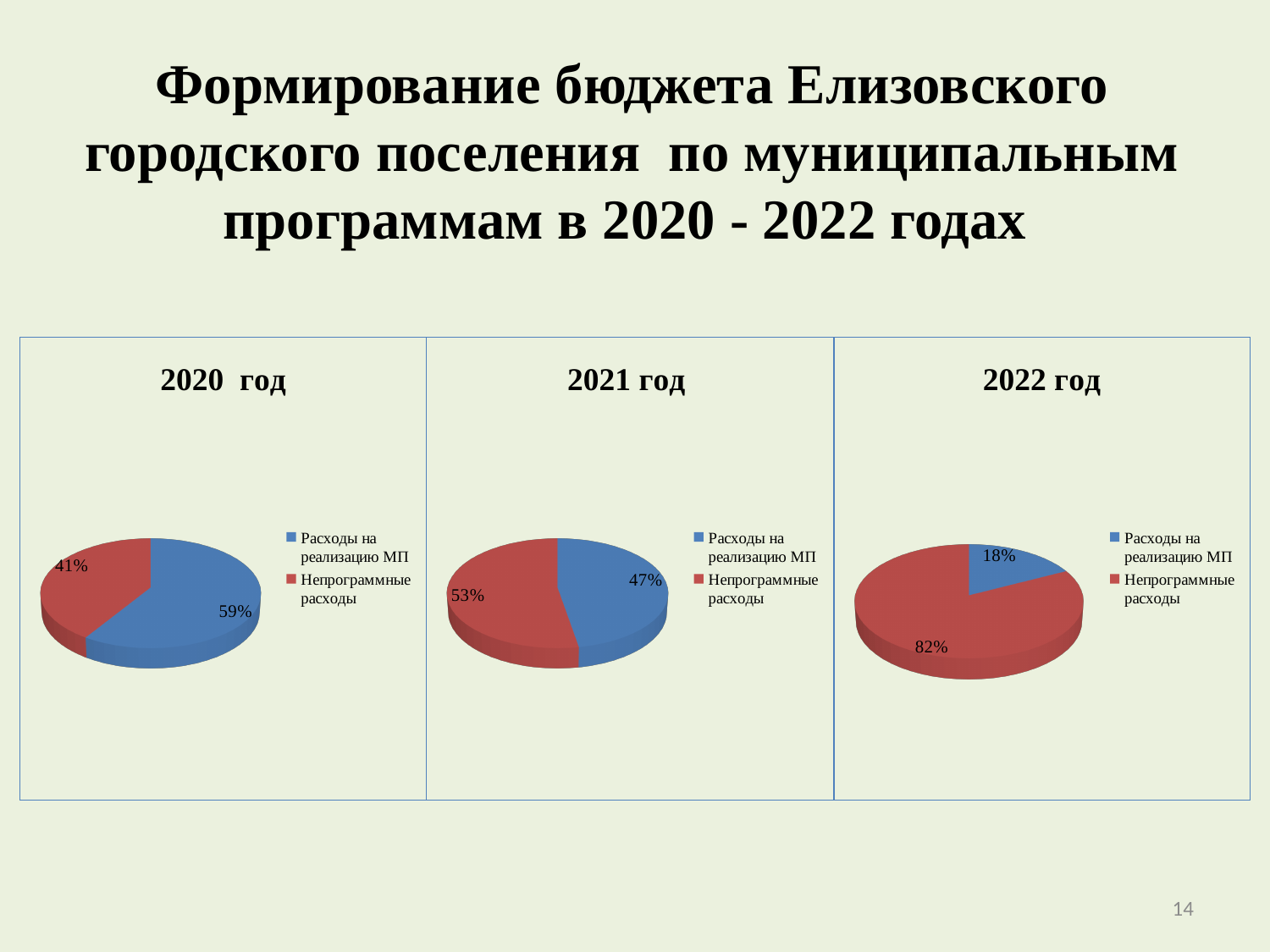
In the "2022 год" chart, what is the difference between the shares of "Непрограммные расходы" and "Расходы на реализацию МП"? 64% What kind of chart is the "2021 год" chart? Pie chart How many entries does the legend of the "2020 год" chart list? 2 In the "2022 год" chart, which slice is the largest? Непрограммные расходы In the "2020 год" chart, which slice is the smallest? Непрограммные расходы In the "2021 год" chart, what share is labelled for "Расходы на реализацию МП"? 47% In the "2020 год" chart, what share is labelled for "Непрограммные расходы"? 41% In the "2021 год" chart, what share is labelled for "Непрограммные расходы"? 53% In the "2022 год" chart, what share is labelled for "Расходы на реализацию МП"? 18% In the "2020 год" chart, what share is labelled for "Расходы на реализацию МП"? 59% In the "2021 год" chart, which is larger: "Расходы на реализацию МП" or "Непрограммные расходы"? Непрограммные расходы In the "2022 год" chart, what share is labelled for "Непрограммные расходы"? 82%